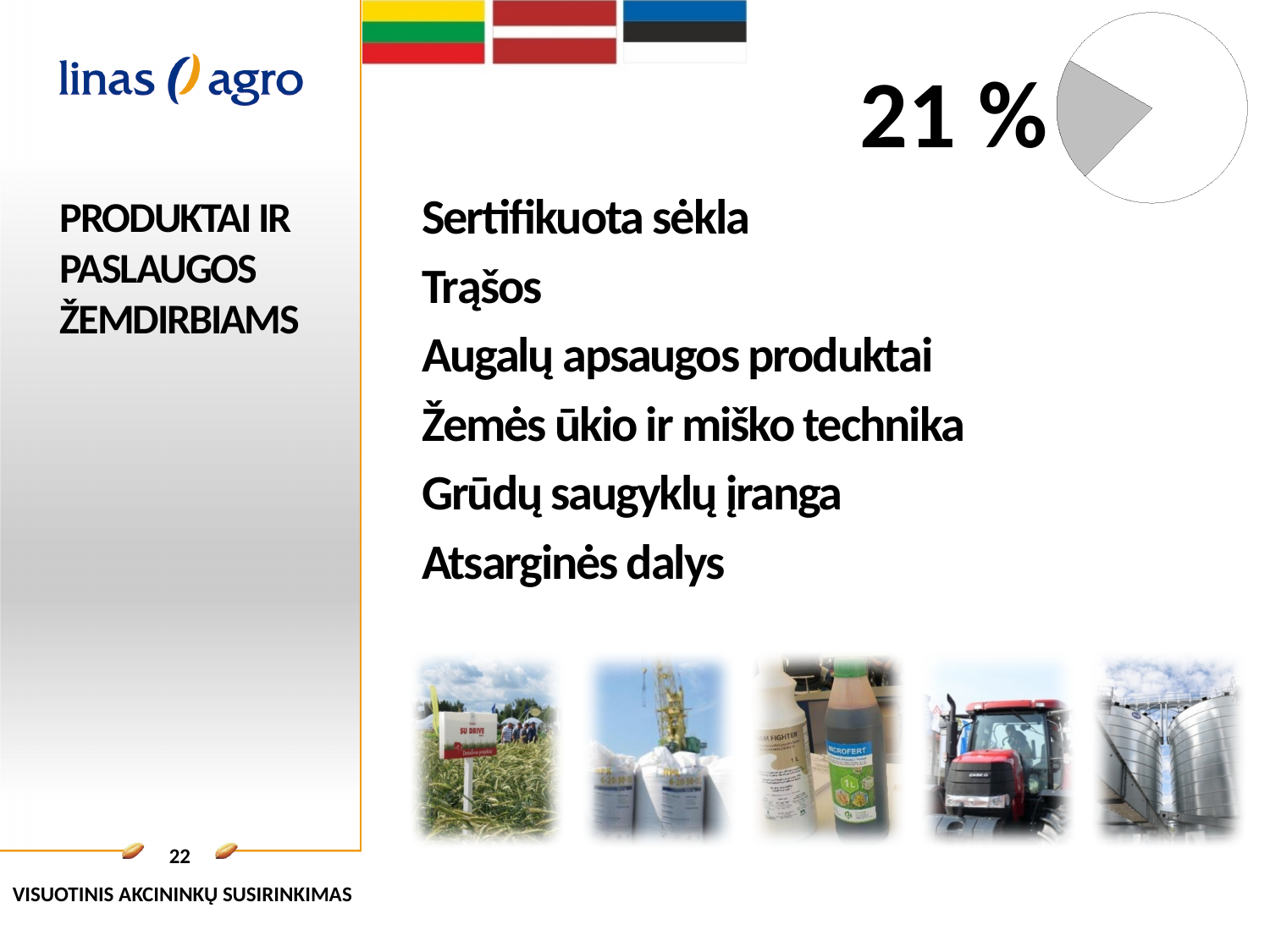
How many slices does the pie chart have? 2 Is the grey slice of the pie chart greater or less than 50%? less What share of the pie chart does the grey slice represent? 21 % What percentage is printed next to the pie chart? 21 % What kind of chart is shown in the top right corner of the slide? pie chart What colour is the highlighted slice of the pie chart labelled 21 %? grey Which slice of the pie chart is larger, the grey slice or the white slice? the white slice